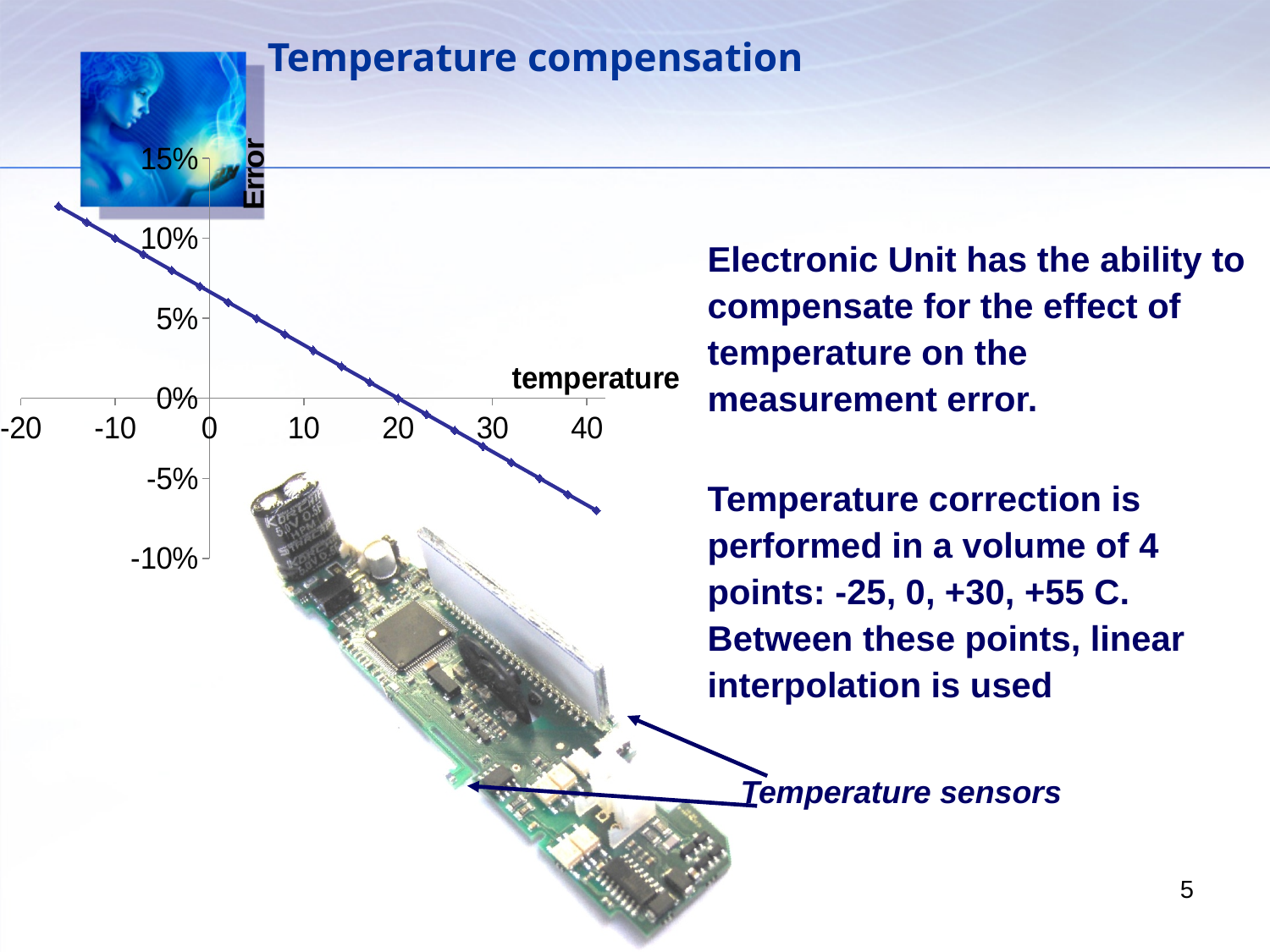
Which has the larger error, the point at temperature 0 or the point at temperature 30? temperature 0 Is the error at a temperature of 10 greater or less than 0%? greater Is the error at a temperature of -10 greater or less than 5%? greater Is the error at a temperature of 30 greater or less than -5%? greater What is the label of the horizontal axis of the chart? temperature What is the label of the vertical axis of the chart? Error As temperature increases along the x axis, does the error rise or fall? fall What kind of chart is shown on the slide? line chart